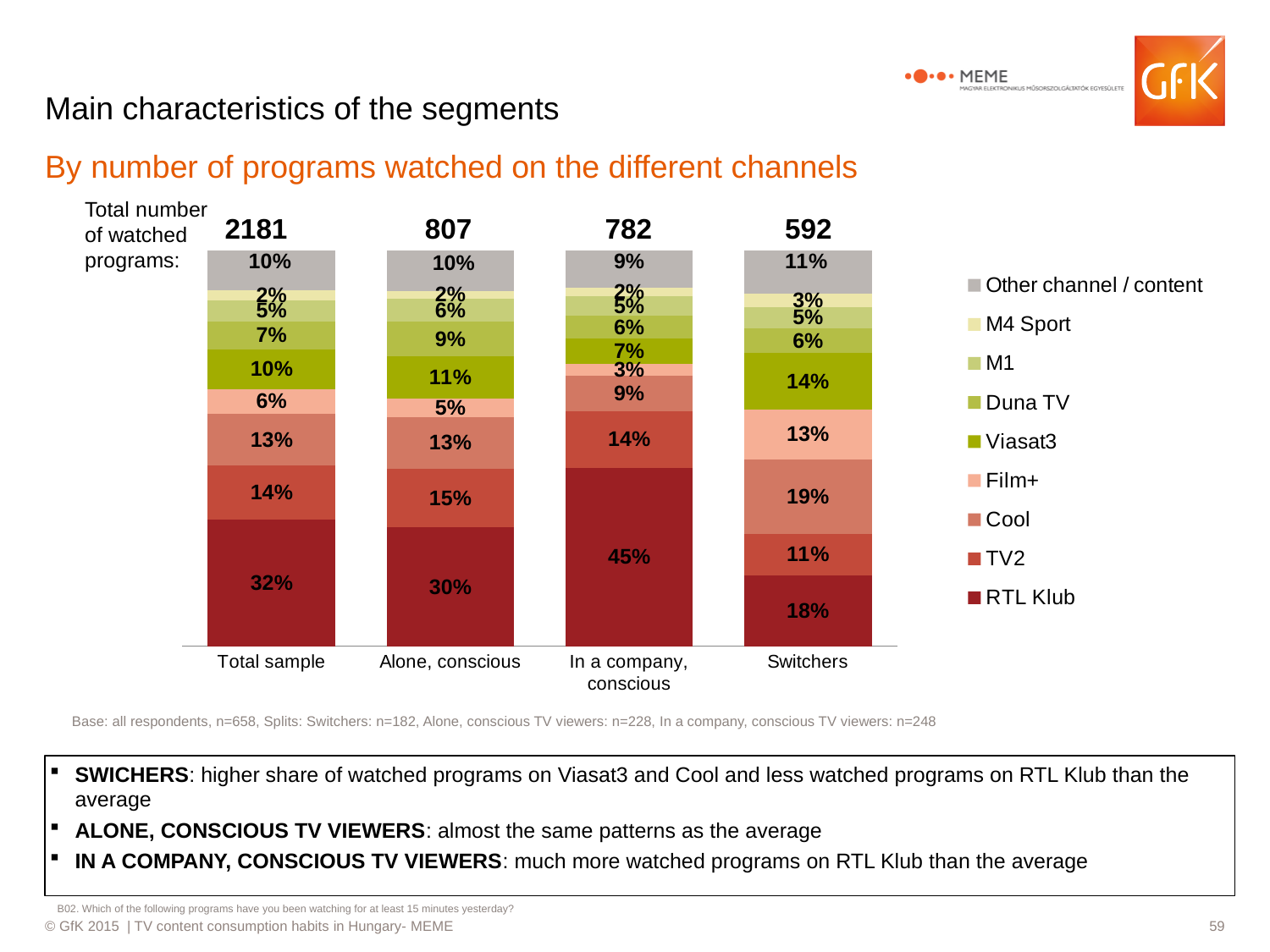
Which segment has the highest share of RTL Klub? In a company, conscious Which series is shown at the top of each stacked bar according to the legend? Other channel / content What is the share of RTL Klub for the 'In a company, conscious' segment? 45% How many series does the chart's legend list? 9 What is the difference between the RTL Klub share in the Total sample and in the Switchers segment? 14 percentage points Which segment has the lowest share of RTL Klub? Switchers How many segments (categories) are shown along the x axis of the chart? 4 What is the share of Viasat3 in the Total sample? 10% Which is larger: the Film+ share for Switchers or the Film+ share for 'Alone, conscious'? Switchers What kind of chart is shown on the slide? Stacked bar chart What is the share of Cool for the Switchers segment? 19% What is the total number of watched programs shown above the Switchers bar? 592